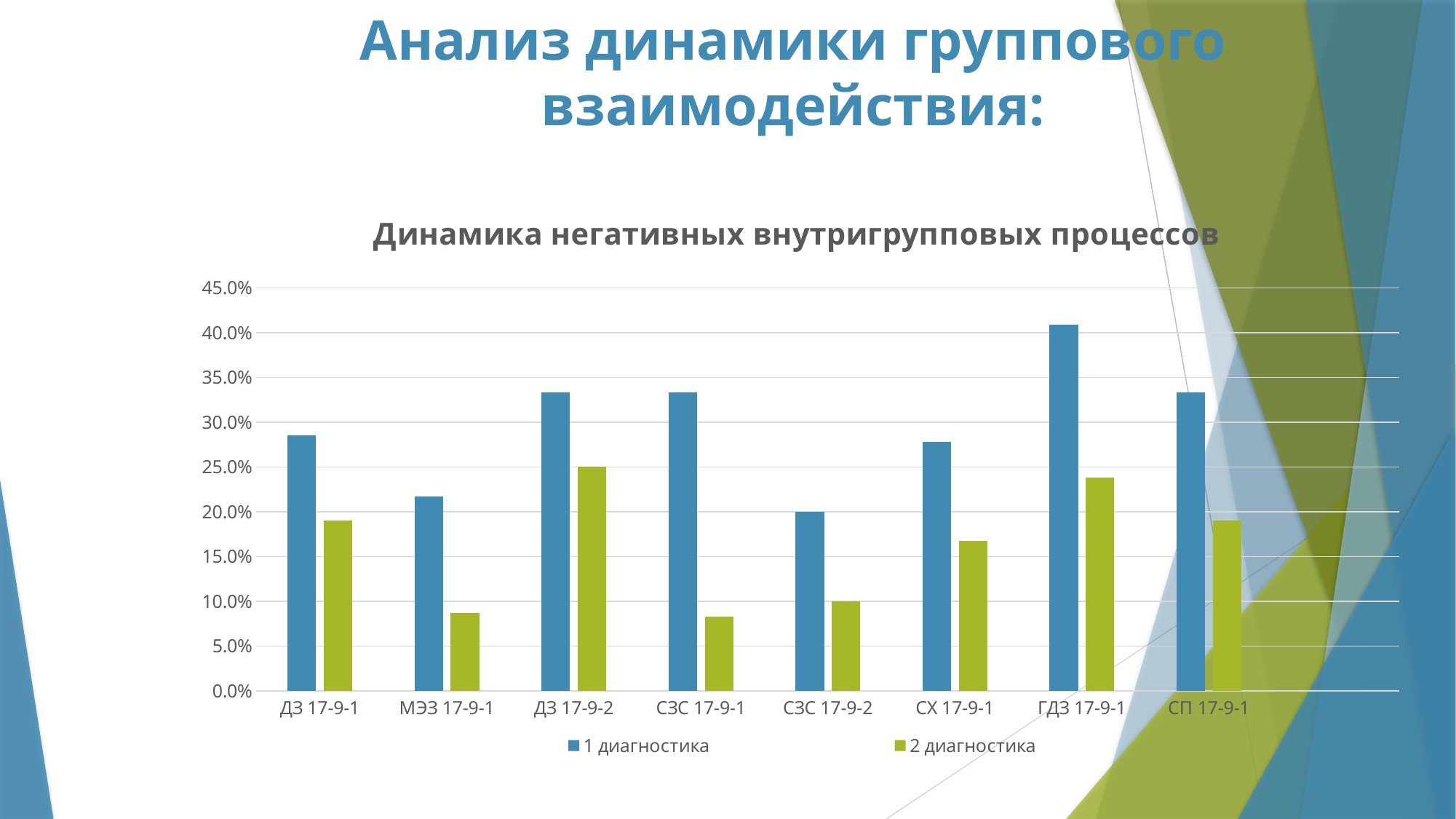
What is the title of the chart? Динамика негативных внутригрупповых процессов What kind of chart is shown on the slide? Bar chart Which colour represents the series 2 диагностика? Green Is the value for 2 диагностика in ДЗ 17-9-2 greater or less than 20.0%? greater How many categories are shown on the x axis? 8 How many series does the legend list? 2 Is the value for 1 диагностика in ГДЗ 17-9-1 greater or less than 35.0%? greater Is the value for 2 диагностика in МЭЗ 17-9-1 greater or less than 10.0%? less For ДЗ 17-9-1, which series has the larger value, 1 диагностика or 2 диагностика? 1 диагностика Which category has the highest value for 1 диагностика? ГДЗ 17-9-1